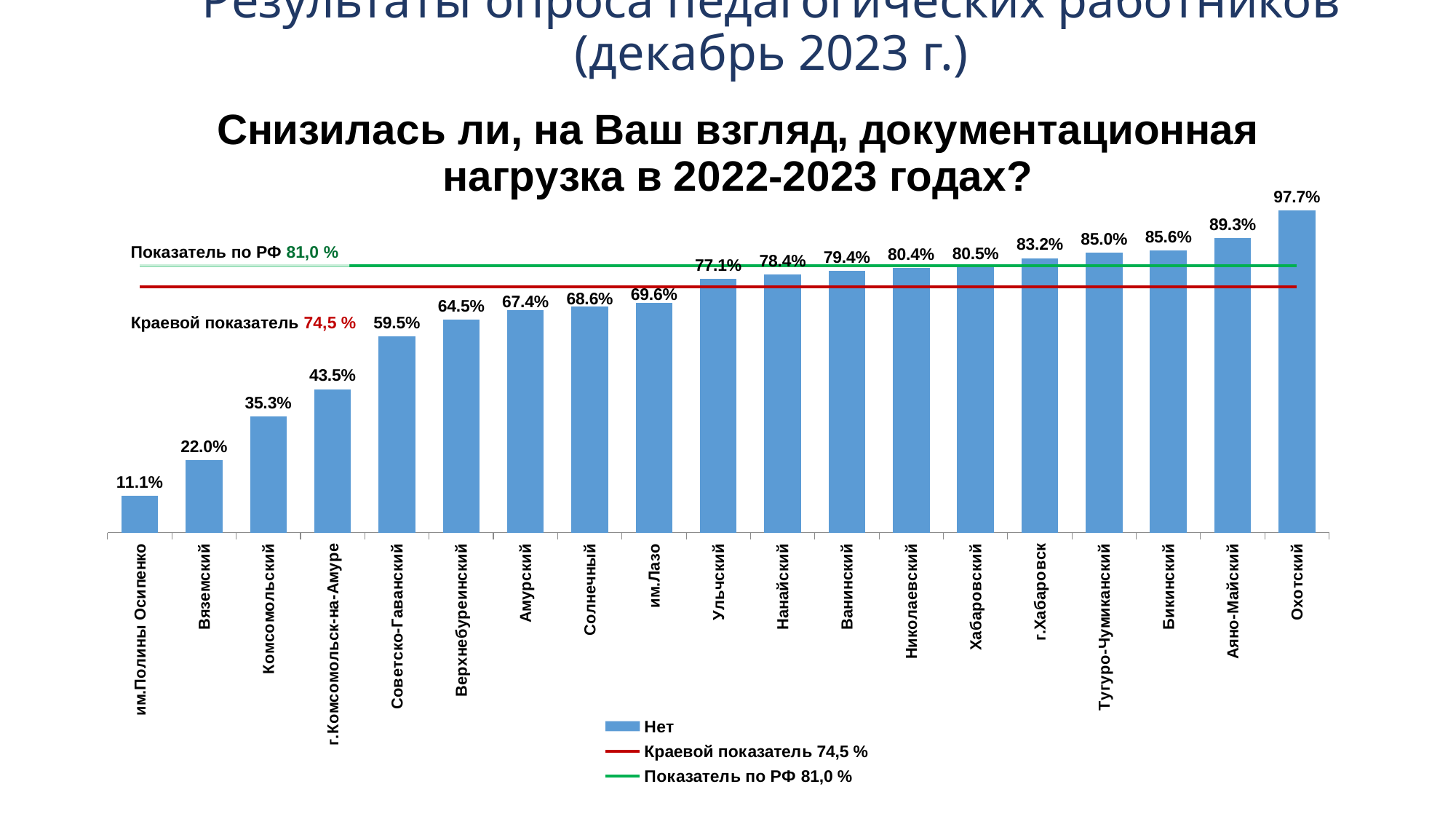
How many districts are shown on the x axis? 19 Which district has the highest value? Охотский What type of chart is shown on the slide? bar chart Which has a larger value, Вяземский or Комсомольский? Комсомольский What is the difference between the values for Аяно-Майский and Бикинский? 3.7% What value does the red line (Краевой показатель) represent? 74,5 % Which district has the lowest value? им.Полины Осипенко What is the value for Охотский? 97.7% Do the values rise or fall from left to right along the x axis? rise What is the value for Нанайский? 78.4% What is the value for г.Комсомольск-на-Амуре? 43.5% How many entries does the legend list? 3